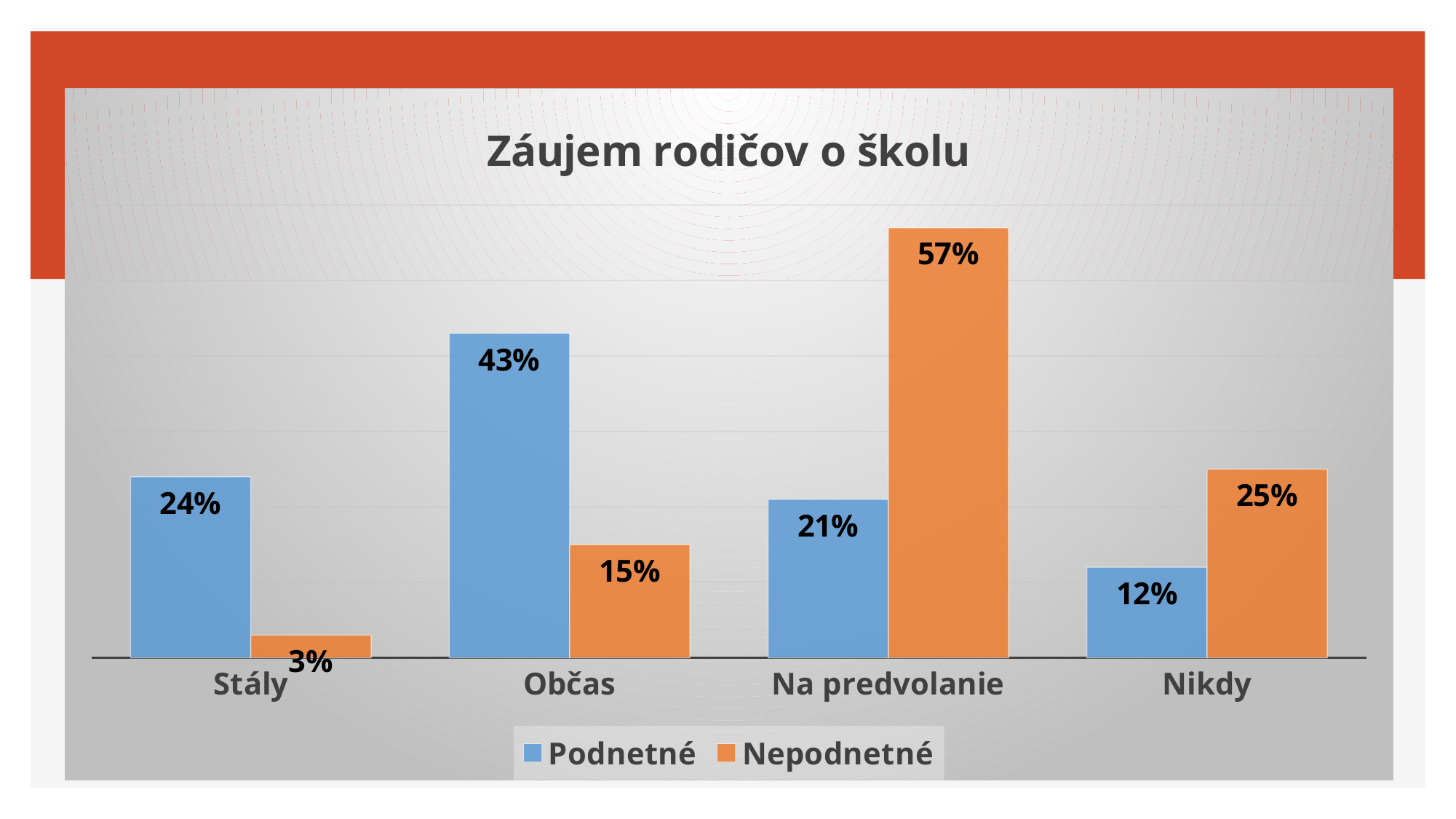
What is the value for Nepodnetné in the Stály category? 3% What is the title of the chart? Záujem rodičov o školu What is the value for Nepodnetné in the Na predvolanie category? 57% What is the value for Podnetné in the Nikdy category? 12% How many series does the legend list? 2 How many categories are shown on the x axis? 4 Which is larger in the Nikdy category, Podnetné or Nepodnetné? Nepodnetné Which category has the highest Podnetné value? Občas Which category has the lowest Nepodnetné value? Stály What is the value for Podnetné in the Občas category? 43% What kind of chart is shown on the slide? Bar chart What is the difference between the Nepodnetné and Podnetné values in the Na predvolanie category? 36%